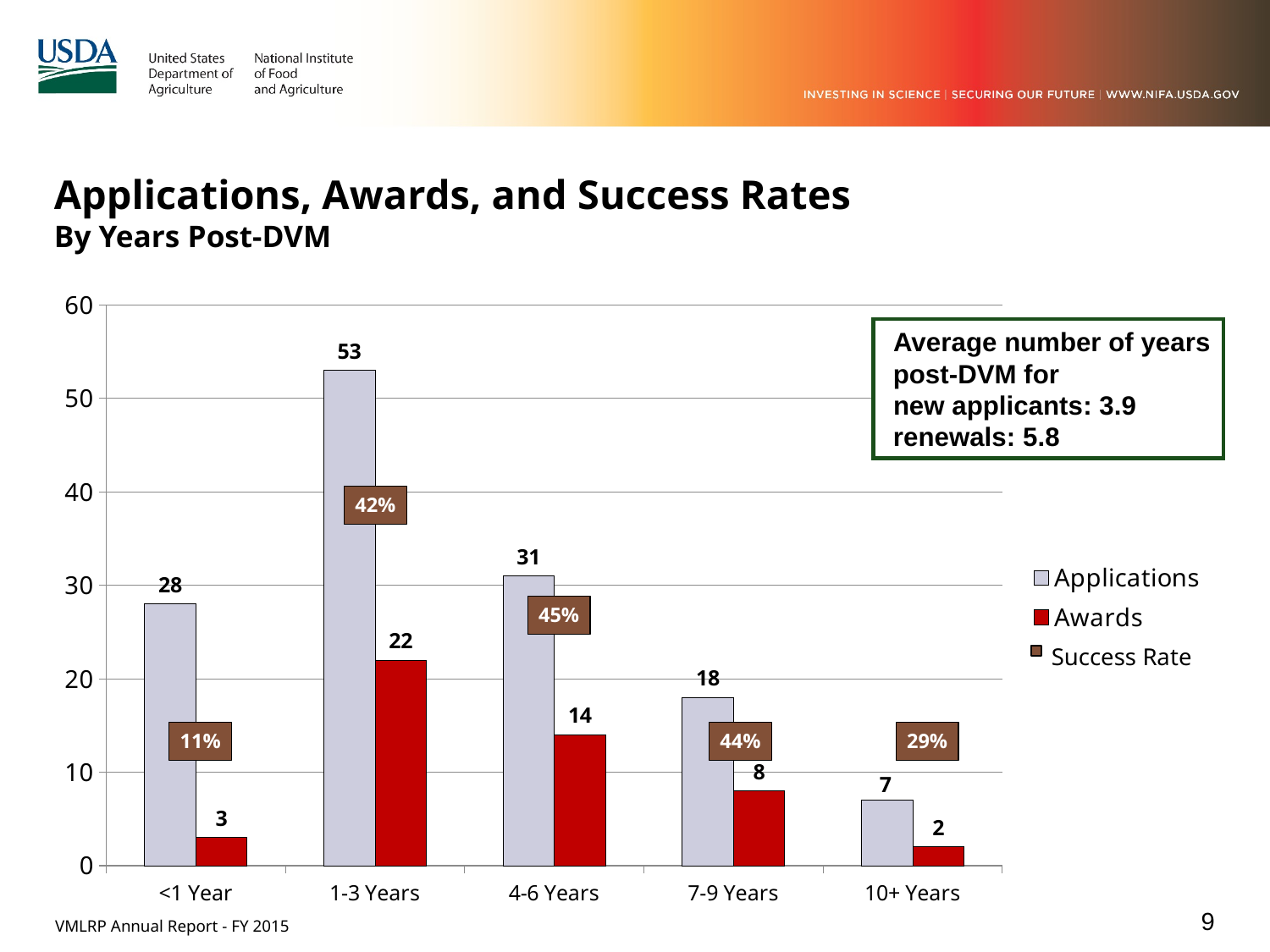
Which category has the highest success rate? 4-6 Years How many series does the legend list? 3 Which category has the highest number of applications? 1-3 Years What kind of chart is shown on the slide? Bar chart Which is larger: the number of awards for 1-3 Years or the number of applications for 7-9 Years? Awards for 1-3 Years How many categories are shown on the x axis? 5 How many applications were there for the 1-3 Years category? 53 What is the difference between applications and awards for the 7-9 Years category? 10 How many awards were there for the 4-6 Years category? 14 What is the average number of years post-DVM for new applicants, according to the text box on the slide? 3.9 Which category has the lowest number of awards? 10+ Years What is the success rate for the <1 Year category? 11%